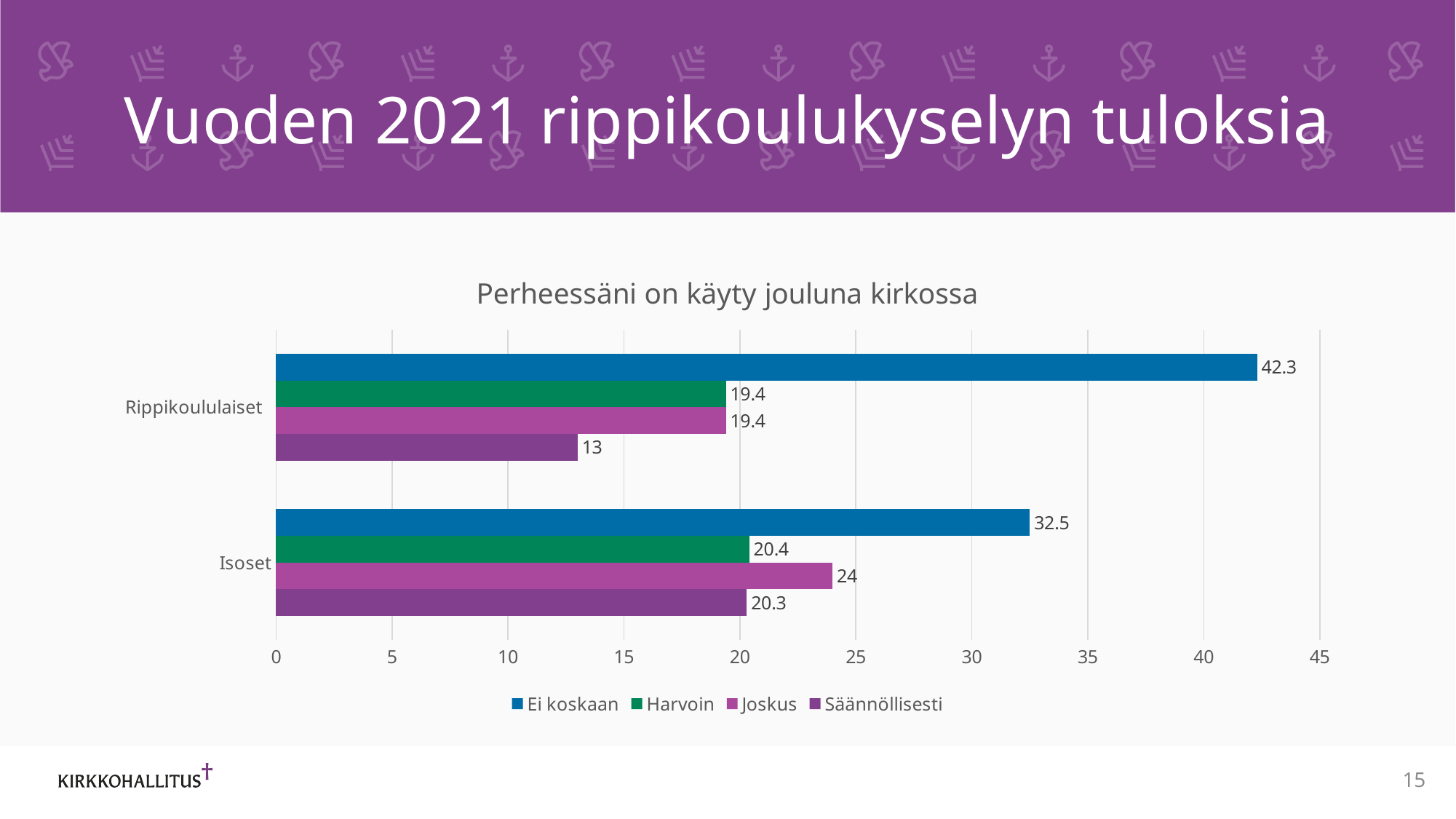
Which series has the highest value for Isoset? Ei koskaan How many series does the legend list? 4 What is the difference between the "Ei koskaan" values for Rippikoululaiset and Isoset? 9.8 What is the value for "Joskus" for Isoset? 24 What is the value for "Harvoin" for Rippikoululaiset? 19.4 What is the value for "Ei koskaan" for Rippikoululaiset? 42.3 What is the title of the chart? Perheessäni on käyty jouluna kirkossa Which is larger: the "Joskus" value for Isoset or the "Joskus" value for Rippikoululaiset? Isoset What is the value for "Säännöllisesti" for Isoset? 20.3 How many categories are shown on the y axis? 2 What kind of chart is shown on the slide? Bar chart Which series has the lowest value for Rippikoululaiset? Säännöllisesti